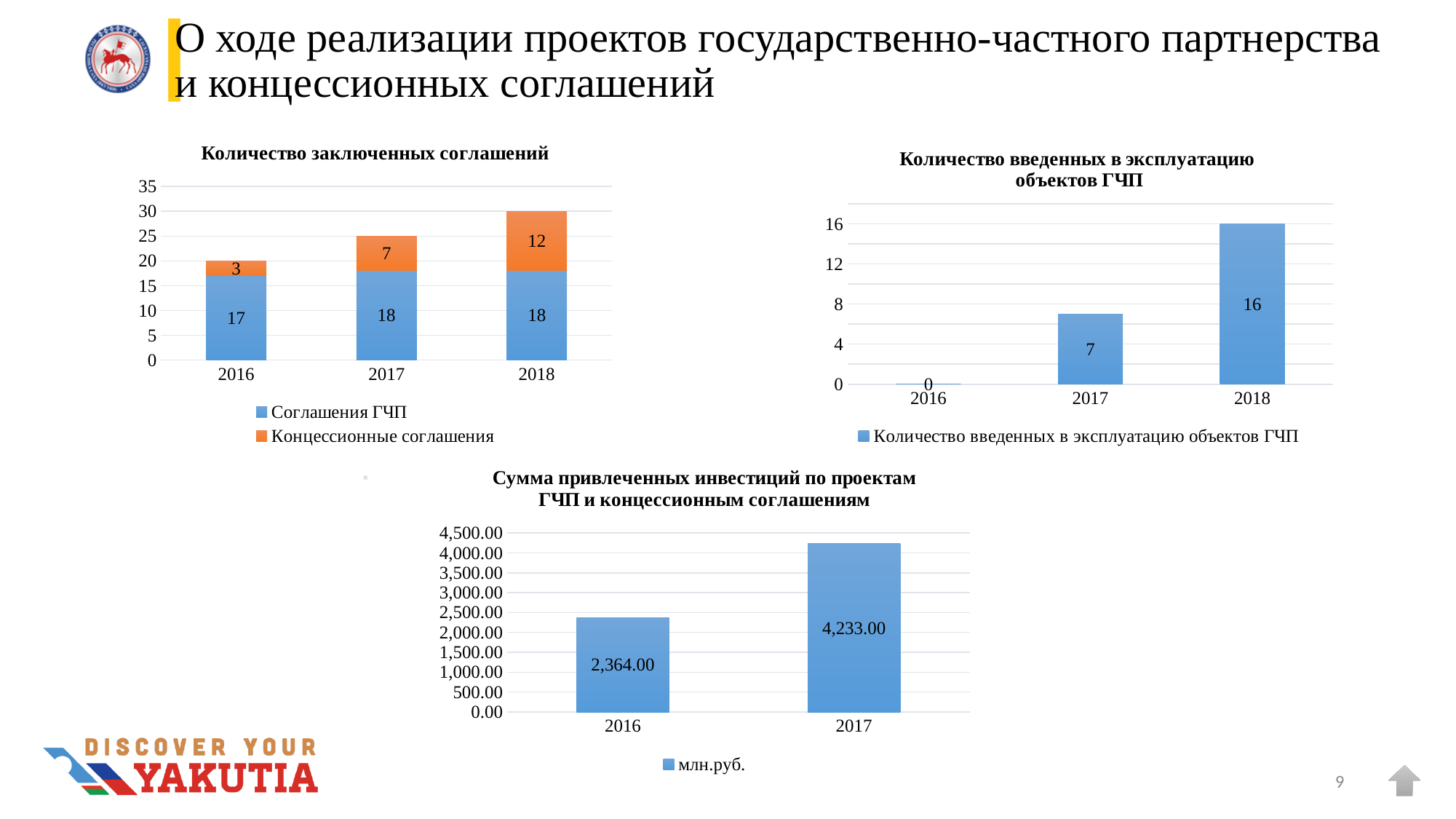
What kind of chart is 'Сумма привлеченных инвестиций по проектам ГЧП и концессионным соглашениям'? bar chart In the chart 'Сумма привлеченных инвестиций по проектам ГЧП и концессионным соглашениям', what is the difference between the 2017 and 2016 values? 1,869.00 In the chart 'Количество введенных в эксплуатацию объектов ГЧП', which year has the highest value? 2018 In the chart 'Сумма привлеченных инвестиций по проектам ГЧП и концессионным соглашениям', what is the value for 2016? 2,364.00 In the chart 'Количество заключенных соглашений', what is the value for 'Концессионные соглашения' in 2018? 12 In the chart 'Количество заключенных соглашений', what is the total of the stacked bar for 2017? 25 In the chart 'Количество введенных в эксплуатацию объектов ГЧП', do the values rise or fall from 2016 to 2018? rise In the chart 'Сумма привлеченных инвестиций по проектам ГЧП и концессионным соглашениям', how many categories are shown on the x axis? 2 In the chart 'Количество заключенных соглашений', what is the value for 'Соглашения ГЧП' in 2016? 17 In the chart 'Количество введенных в эксплуатацию объектов ГЧП', what is the value for 2017? 7 In the chart 'Количество заключенных соглашений', how many series does the legend list? 2 In the chart 'Количество заключенных соглашений', what is the difference between the 'Концессионные соглашения' values for 2018 and 2016? 9